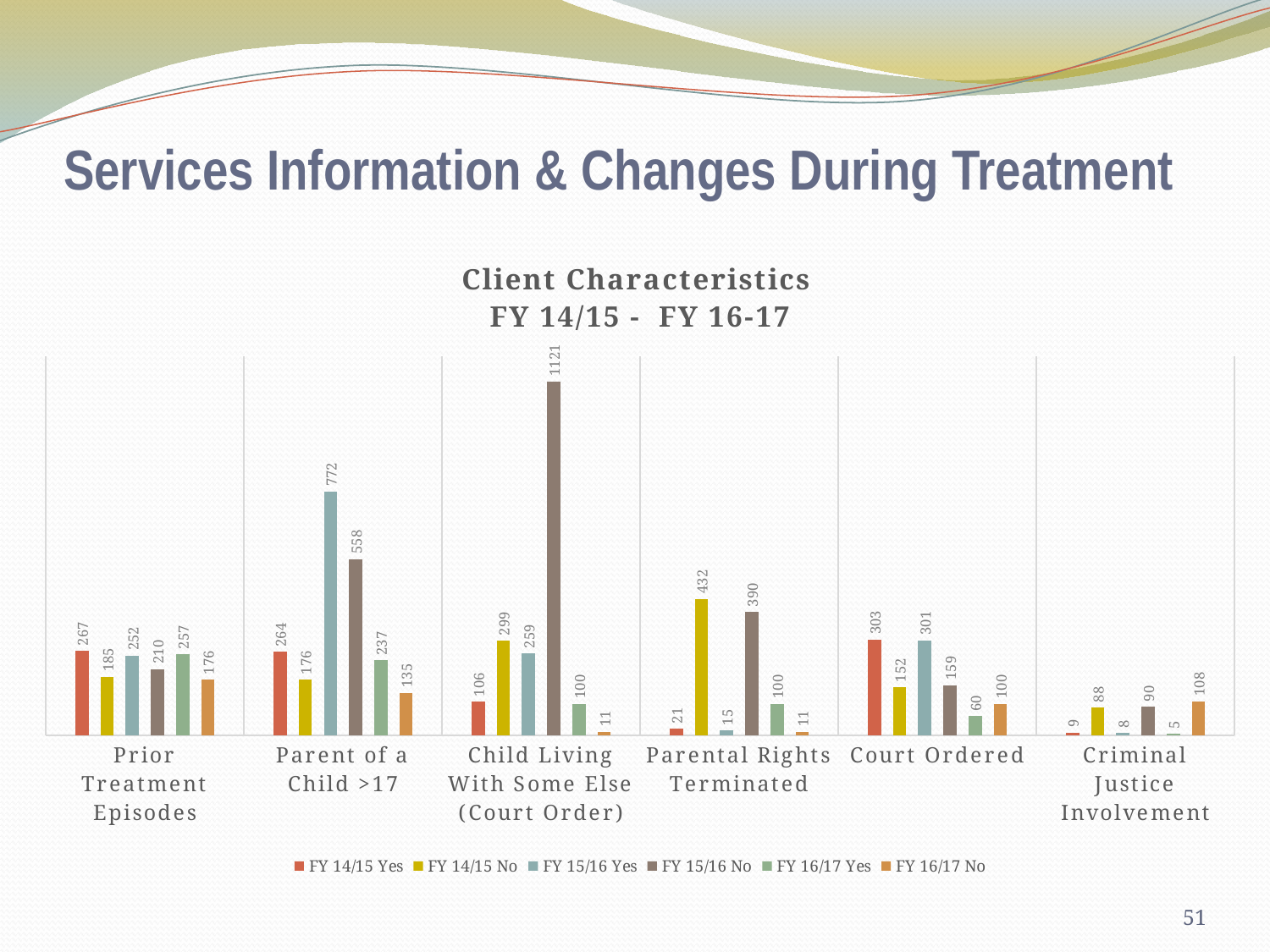
What is the value for FY 16/17 No in the Criminal Justice Involvement category? 108 Which is larger in the Prior Treatment Episodes category: FY 14/15 Yes or FY 16/17 No? FY 14/15 Yes What is the title of the chart? Client Characteristics FY 14/15 - FY 16-17 What is the value for FY 14/15 No in the Parental Rights Terminated category? 432 Which series has the highest value in the Court Ordered category? FY 14/15 Yes What is the difference between FY 15/16 Yes and FY 15/16 No in the Parent of a Child >17 category? 214 What is the value for FY 15/16 No in the Child Living With Some Else (Court Order) category? 1121 Which series has the lowest value in the Criminal Justice Involvement category? FY 16/17 Yes How many categories are shown on the x axis? 6 What type of chart is shown on the slide? Bar chart How many series does the legend list? 6 What is the value for FY 15/16 Yes in the Parent of a Child >17 category? 772